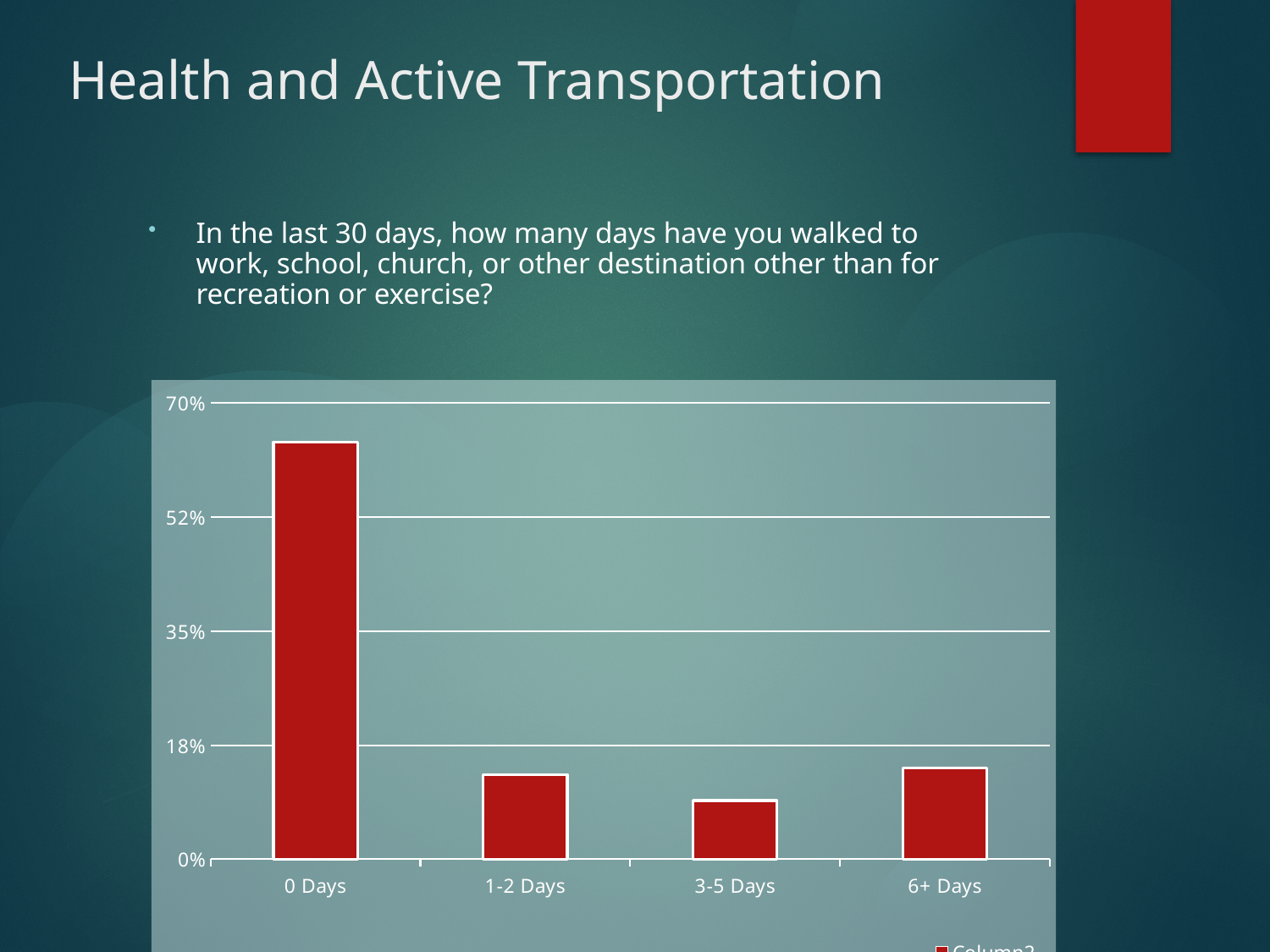
Is the value for 6+ Days greater or less than 18%? less Is the value for 0 Days greater or less than 52%? greater Which is larger, the value for 3-5 Days or the value for 6+ Days? 6+ Days How many categories are shown on the x axis of the chart? 4 What kind of chart is shown on the slide? bar chart Is the value for 0 Days greater or less than 70%? less Which is larger, the value for 0 Days or the value for 1-2 Days? 0 Days Which category has the highest bar in the chart? 0 Days Which category has the lowest bar in the chart? 3-5 Days What is the highest value labelled on the vertical axis of the chart? 70%